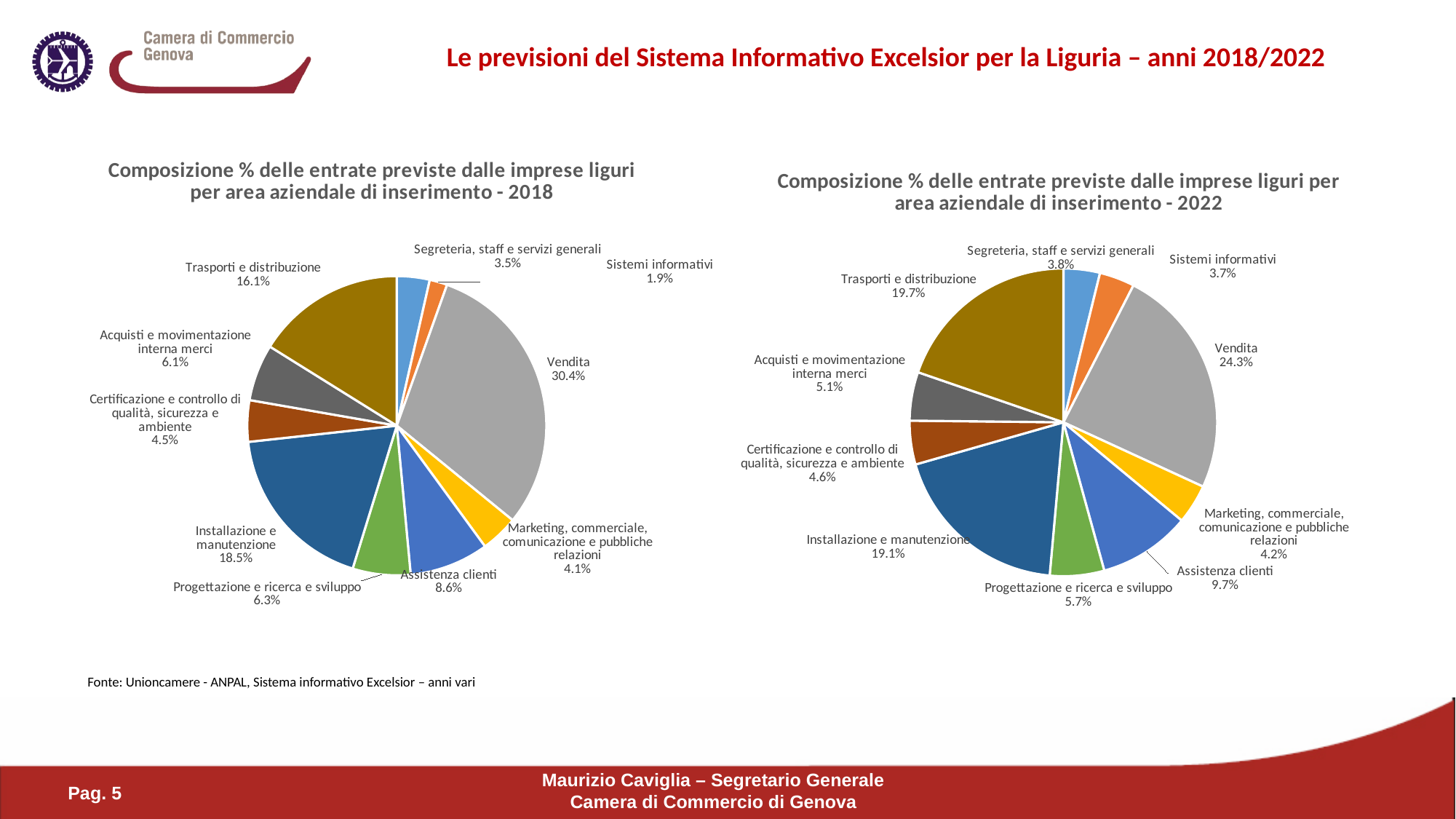
What type of chart is used on this slide? Pie chart In the 2018 chart, which area has the smallest share? Sistemi informativi In the 2022 chart, which is larger: Installazione e manutenzione or Trasporti e distribuzione? Trasporti e distribuzione In the 2018 chart, what is the value for Assistenza clienti? 8.6% In the 2022 chart, which area has the largest share? Vendita What is the difference between the Vendita share in the 2018 chart and in the 2022 chart? 6.1 percentage points In the 2022 chart, what share of expected hires is in Trasporti e distribuzione? 19.7% In the 2018 chart, what share of expected hires is in Vendita? 30.4% In the 2022 chart, what is the value for Sistemi informativi? 3.7% In the 2018 chart, what is the difference between Installazione e manutenzione and Trasporti e distribuzione? 2.4 percentage points How many areas (slices) are shown in the 2022 chart? 10 In the 2018 chart, which area has the largest share? Vendita